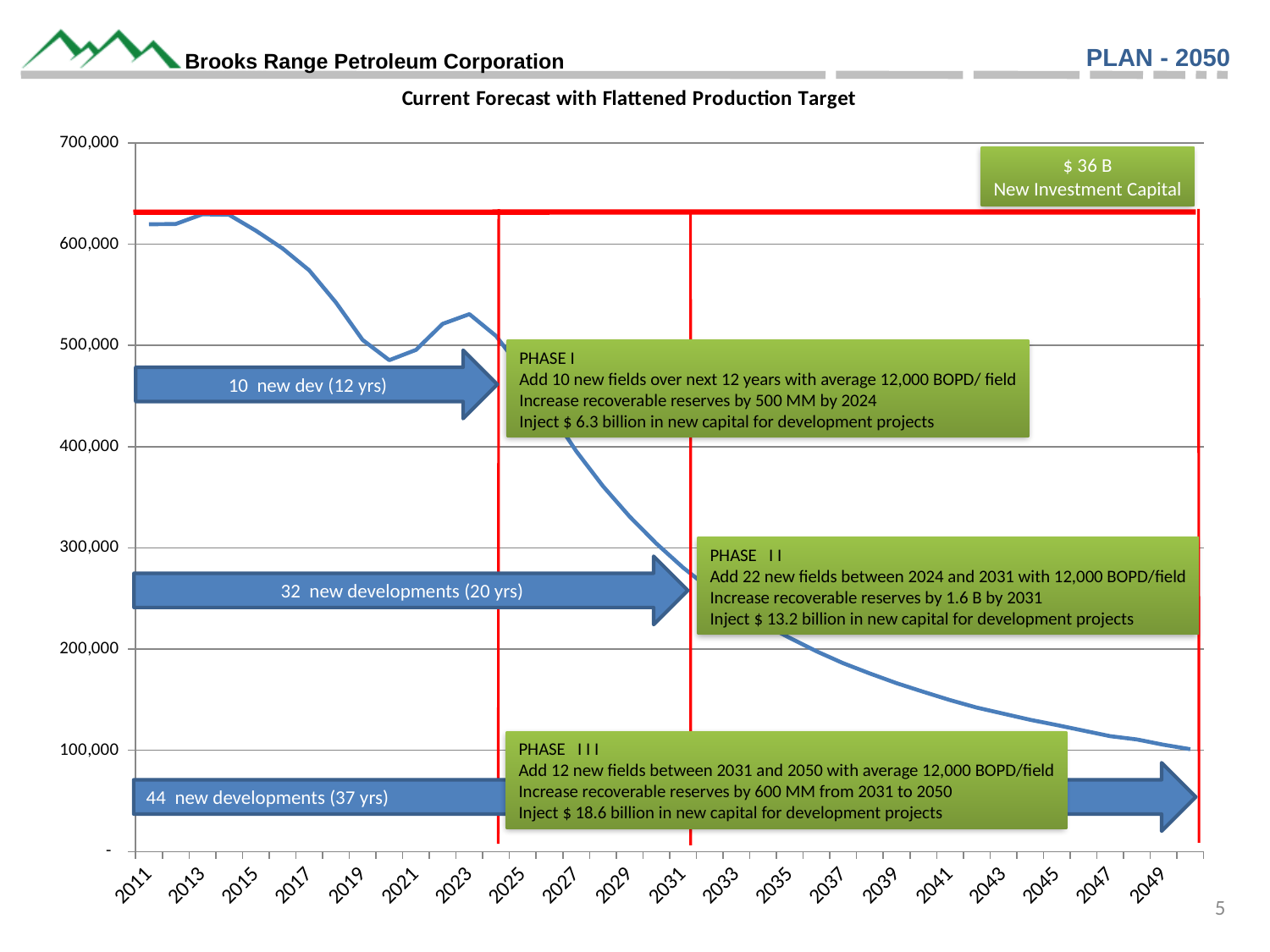
Is the value for 2019 greater or less than 600,000? less Is the value for 2027 greater or less than 500,000? less Is the value for 2035 greater or less than 300,000? less Which is larger, the value for 2015 or the value for 2021? 2015 Do the plotted production values generally rise or fall from 2011 to 2049? fall What is the title of the chart? Current Forecast with Flattened Production Target What type of chart is shown on the slide? line chart What amount of new investment capital is stated in the green box at the top right of the chart? $ 36 B How many year labels are shown on the x axis? 20 Which is larger, the value for 2011 or the value for 2049? 2011